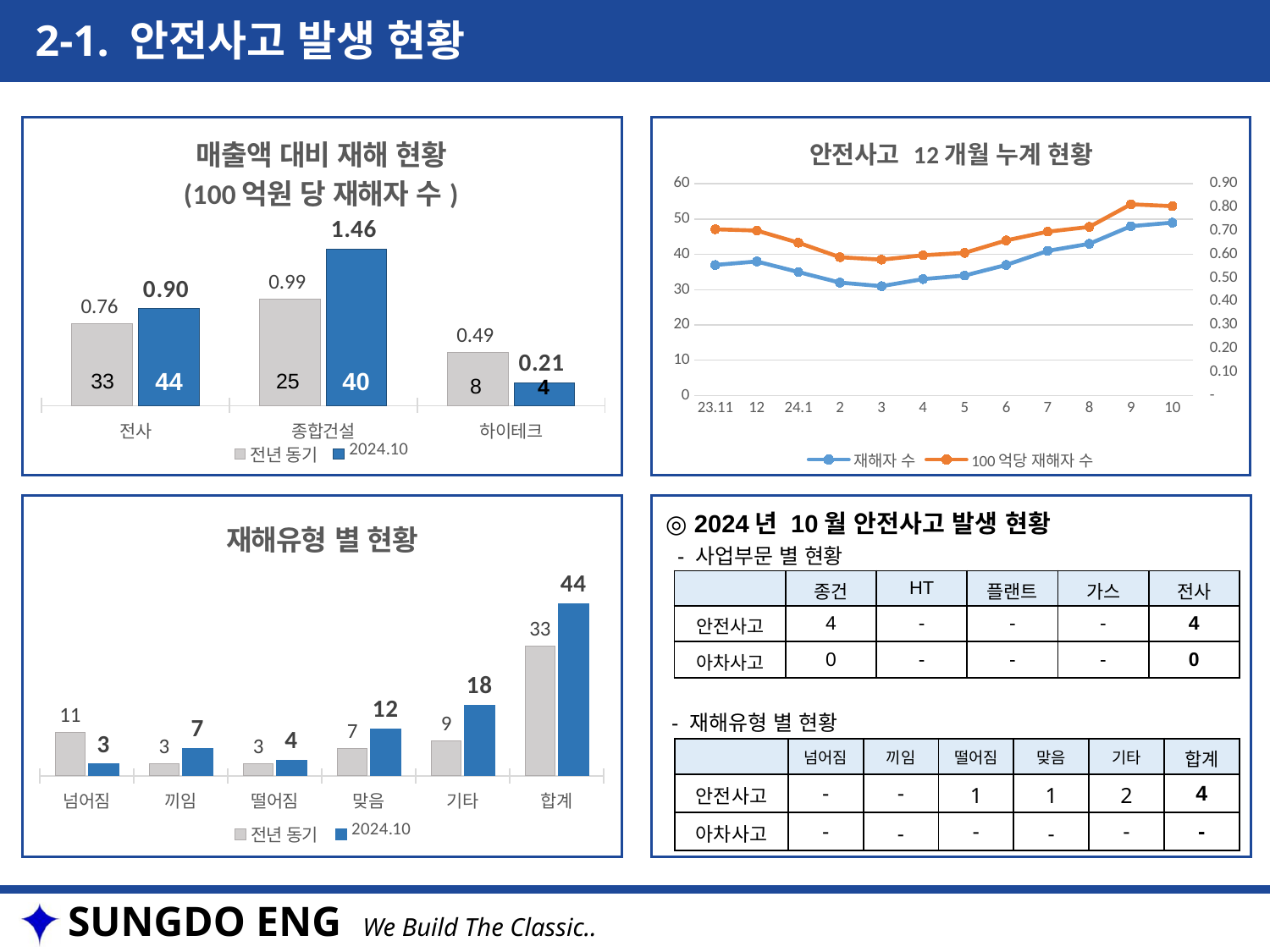
In the chart titled 매출액 대비 재해 현황, what is the 전년 동기 value for 하이테크? 0.49 In the chart titled 재해유형 별 현황, which category other than 합계 has the lowest 2024.10 value? 넘어짐 What kind of chart is the chart titled 재해유형 별 현황? bar chart In the chart titled 안전사고 12개월 누계 현황, how many points are plotted along the x axis for each series? 12 In the chart titled 재해유형 별 현황, what is the 2024.10 value for 기타? 18 In the chart titled 매출액 대비 재해 현황, which category has the highest 2024.10 value? 종합건설 In the chart titled 매출액 대비 재해 현황, what is the 2024.10 value for 종합건설? 1.46 In the chart titled 재해유형 별 현황, what is the difference between the 2024.10 and 전년 동기 values for 맞음? 5 In the chart titled 재해유형 별 현황, is the 전년 동기 value for 넘어짐 larger or smaller than its 2024.10 value? larger In the chart titled 안전사고 12개월 누계 현황, is the 재해자 수 value at 3 greater or less than 40? less In the chart titled 매출액 대비 재해 현황, how many series does the legend list? 2 In the chart titled 매출액 대비 재해 현황, what is the difference between the 2024.10 and 전년 동기 values for 전사? 0.14